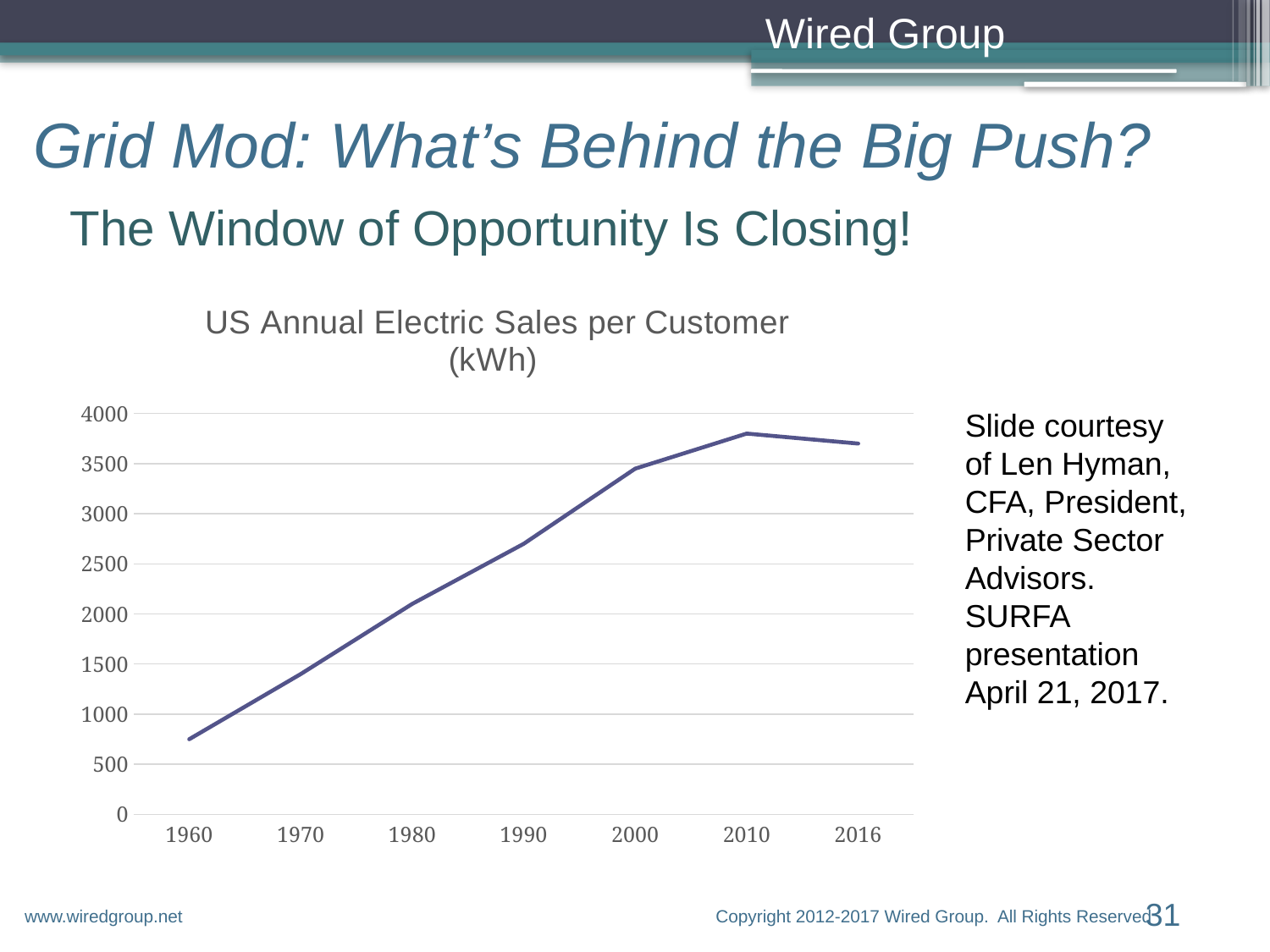
How many years are labelled on the x axis of the chart? 7 What kind of chart is shown on the slide? line chart In which year is the value on the chart lowest? 1960 Is the value for 1960 greater or less than 1000? less Which year has the larger value, 1990 or 2010? 2010 How many lines are plotted on the chart? 1 Does the value rise or fall between 1960 and 2010? rise Is the value for 1980 greater or less than 2000? greater What is the title of the chart? US Annual Electric Sales per Customer (kWh) In which year is the value on the chart highest? 2010 Is the value for 2016 greater or less than 4000? less